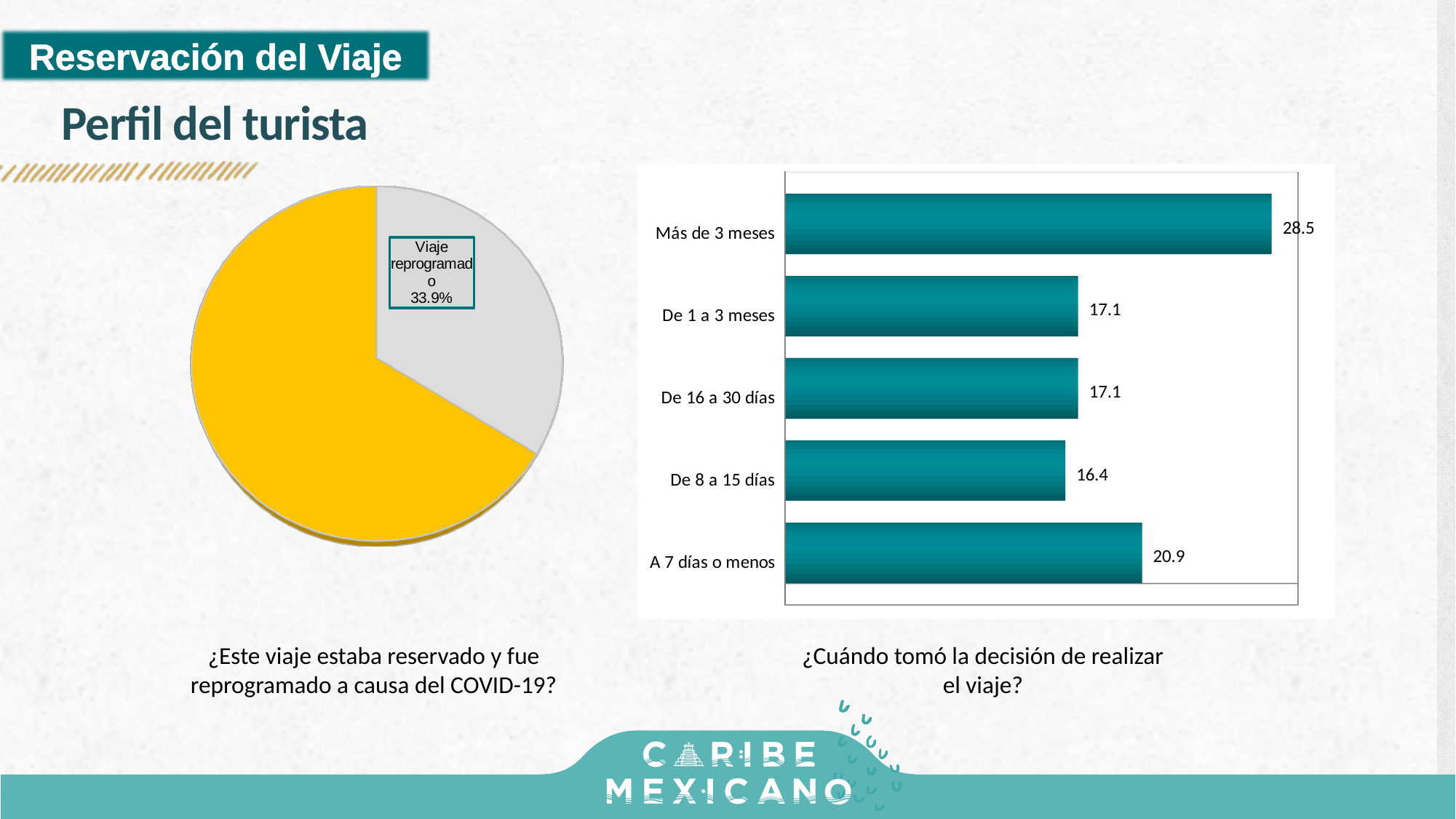
In the bar chart on the right, what is the difference between 'Más de 3 meses' and 'A 7 días o menos'? 7.6 How many categories does the bar chart on the right show? 5 In the pie chart on the left, what share is labelled 'Viaje reprogramado'? 33.9% What kind of chart is shown on the left side of the slide? Pie chart What kind of chart is shown on the right side of the slide? Bar chart In the bar chart on the right, what is the value for 'Más de 3 meses'? 28.5 In the bar chart on the right, which two categories share the same value of 17.1? De 1 a 3 meses and De 16 a 30 días In the bar chart on the right, what is the value for 'De 8 a 15 días'? 16.4 In the bar chart on the right, what is the value for 'A 7 días o menos'? 20.9 In the bar chart on the right, which is larger: 'A 7 días o menos' or 'De 1 a 3 meses'? A 7 días o menos In the bar chart on the right, which category has the lowest value? De 8 a 15 días In the bar chart on the right, which category has the highest value? Más de 3 meses